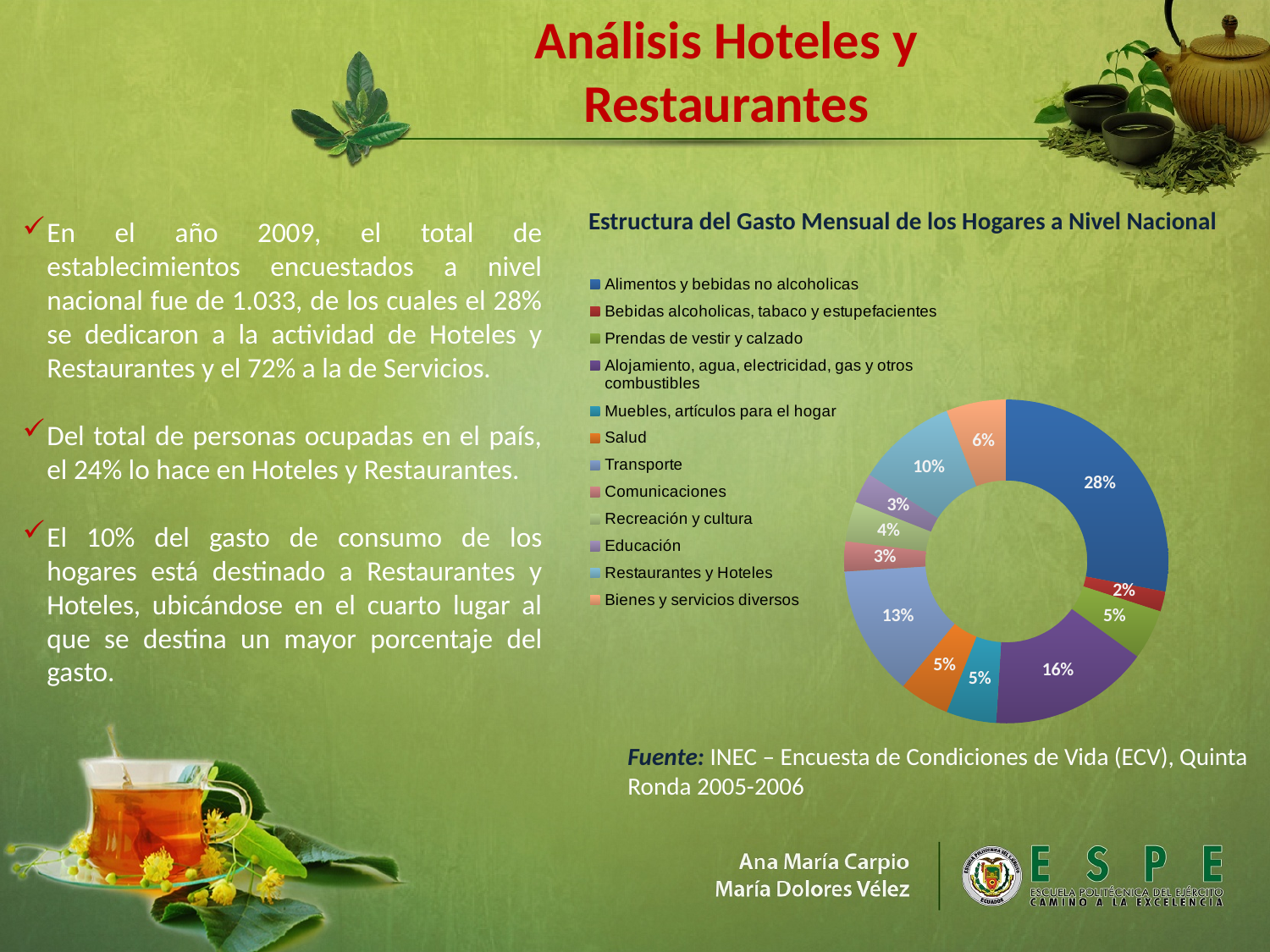
How many categories does the chart's legend list? 12 What type of chart is shown on the slide? Doughnut (pie) chart What percentage of household spending goes to Alimentos y bebidas no alcoholicas? 28% What percentage of household spending goes to Transporte? 13% What percentage of household spending goes to Bienes y servicios diversos? 6% What is the difference in percentage points between Alimentos y bebidas no alcoholicas and Restaurantes y Hoteles? 18 What is the title of the chart on the slide? Estructura del Gasto Mensual de los Hogares a Nivel Nacional Which category has the largest share of household spending? Alimentos y bebidas no alcoholicas What percentage of household spending goes to Restaurantes y Hoteles? 10% Which has a larger share: Transporte or Restaurantes y Hoteles? Transporte Which category has the smallest share of household spending? Bebidas alcoholicas, tabaco y estupefacientes What percentage of household spending goes to Alojamiento, agua, electricidad, gas y otros combustibles? 16%